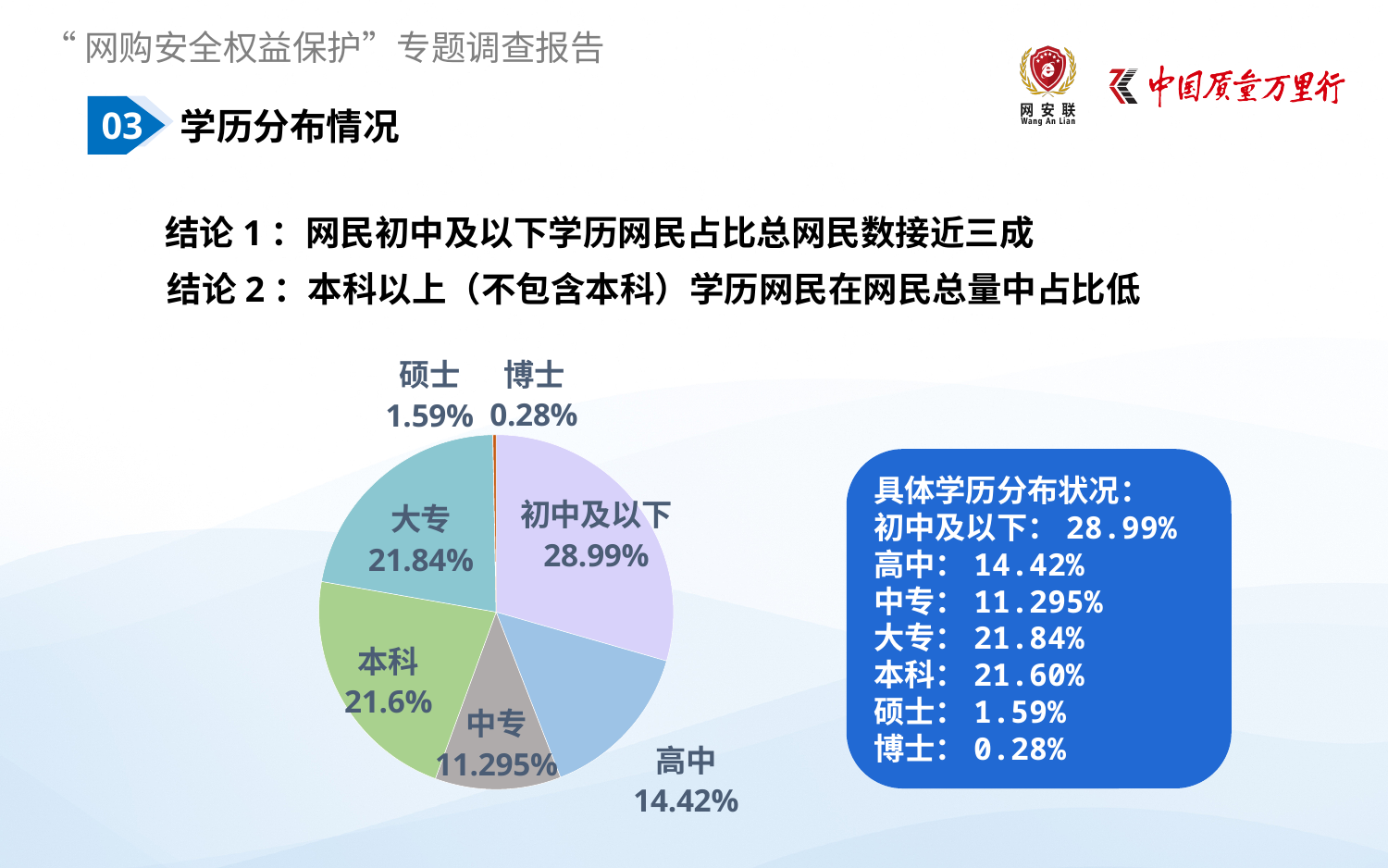
What is the value shown for 中专 in the pie chart? 11.295% Which category has the largest slice in the pie chart? 初中及以下 Which is larger in the pie chart, 大专 or 本科? 大专 How many categories are shown in the pie chart? 7 Which category has the smallest slice in the pie chart? 博士 What share of the pie does 初中及以下 represent? 28.99% What is the difference between the values for 硕士 and 博士? 1.31% What is the difference between the values for 初中及以下 and 高中? 14.57% What type of chart is shown on the slide? Pie chart What is the value shown for 博士 in the pie chart? 0.28% What is the title of the section containing the pie chart? 学历分布情况 What is the value shown for 高中 in the pie chart? 14.42%